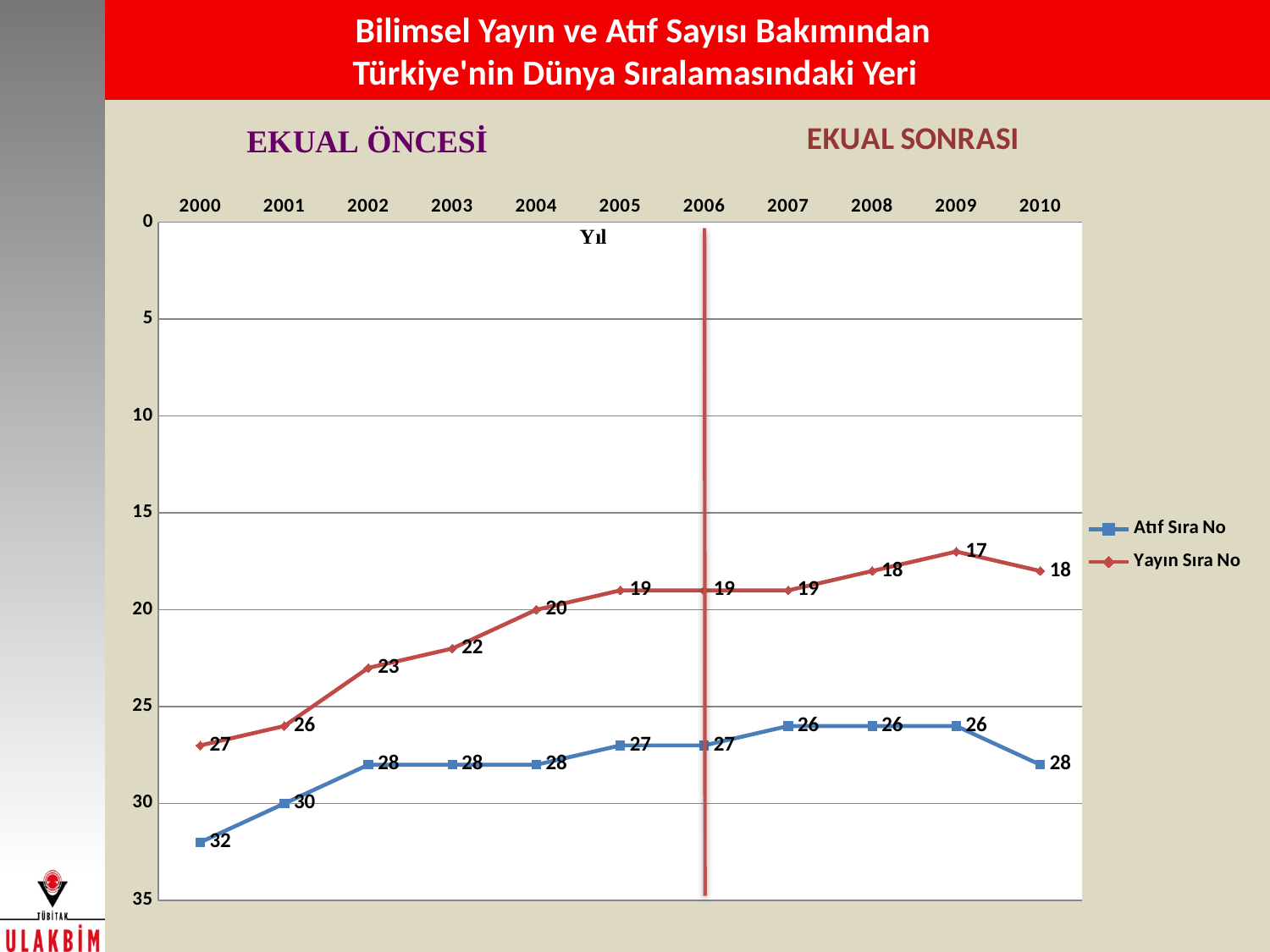
What is the Yayın Sıra No value for 2004? 20 How many years are shown on the x axis? 11 What is the Atıf Sıra No value for 2010? 28 What is the difference between the Yayın Sıra No value in 2000 and in 2010? 9 Which is numerically larger in 2005: the Atıf Sıra No value or the Yayın Sıra No value? Atıf Sıra No What is the Atıf Sıra No value for 2000? 32 What is the Yayın Sıra No value for 2009? 17 In which year is the Yayın Sıra No value numerically lowest? 2009 In which year is the Atıf Sıra No value numerically highest? 2000 How many series does the legend list? 2 What kind of chart is shown on the slide? Line chart What is the difference between the Atıf Sıra No value in 2000 and in 2009? 6